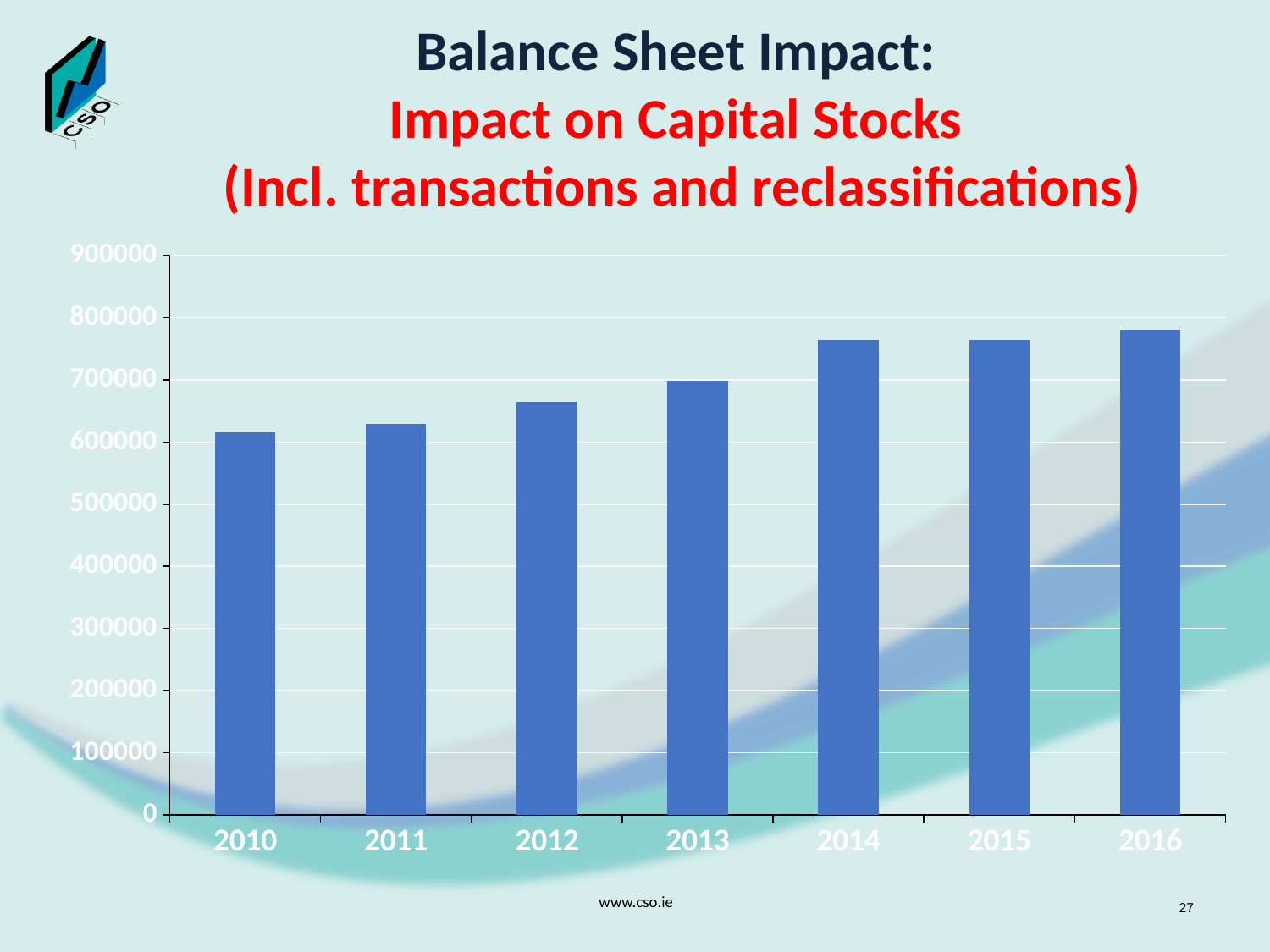
Is the value for 2014 greater or less than 700000? greater What is the highest value shown on the y axis of the chart? 900000 Which is larger, the value for 2014 or the value for 2010? 2014 Which is larger, the value for 2013 or the value for 2012? 2013 Is the value for 2010 greater or less than 700000? less Is the value for 2012 greater or less than 600000? greater How many years (bars) are shown on the x axis of the chart? 7 What kind of chart is shown on the slide? Bar chart Do the values generally rise or fall from 2010 to 2016? rise Which years does the chart cover, from first to last? 2010 to 2016